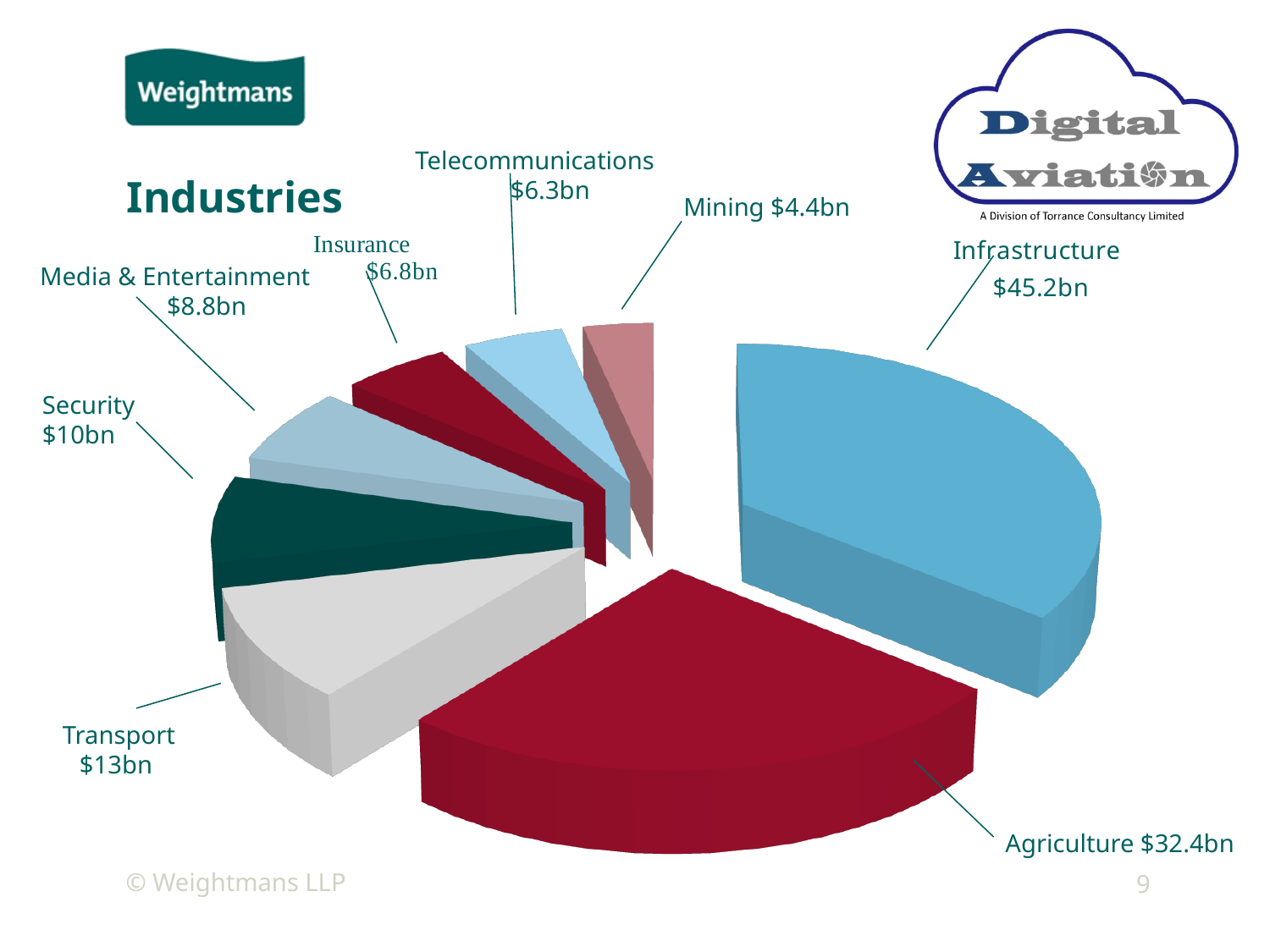
What kind of chart is shown on the slide? Pie chart Which industry has the smallest slice of the pie? Mining How many industries are shown in the pie chart? 8 Which industry has the largest slice of the pie? Infrastructure What is the value for Infrastructure? $45.2bn What is the difference between the Infrastructure and Agriculture values? $12.8bn What is the value for Mining? $4.4bn What is the difference between the Transport and Security values? $3bn What is the value for Agriculture? $32.4bn What is the title of the chart? Industries What is the value for Media & Entertainment? $8.8bn Which is larger, Insurance or Telecommunications? Insurance